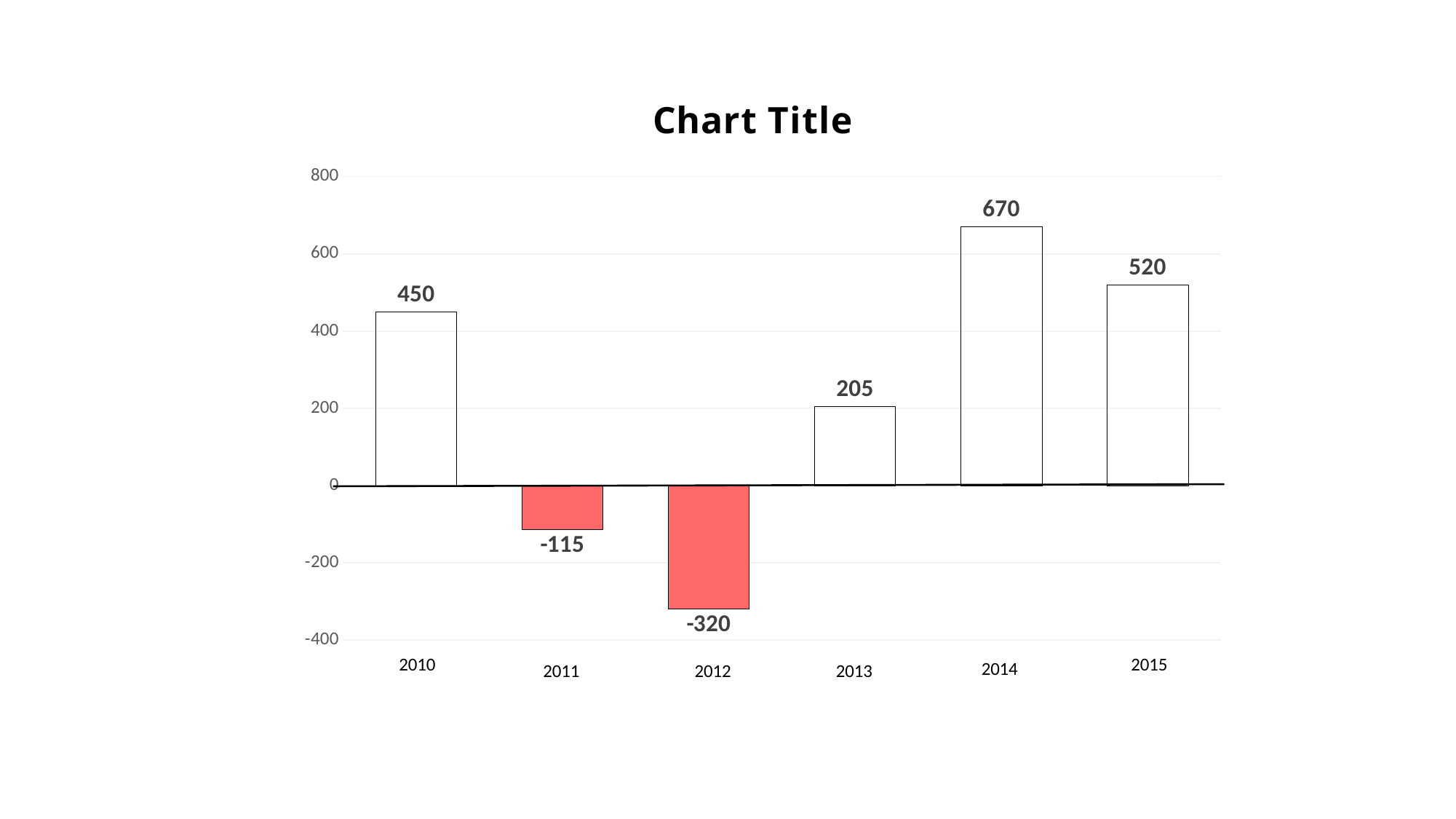
How many years are shown on the x axis? 6 What is the value for 2014? 670 What is the difference between the values for 2010 and 2013? 245 What is the difference between the values for 2014 and 2015? 150 What kind of chart is shown on the slide? Bar chart What is the value for 2010? 450 Which year has the lowest value? 2012 Which is larger, the value for 2010 or the value for 2015? 2015 Which year has the highest value? 2014 What is the value for 2011? -115 What is the title of the chart? Chart Title What is the value for 2012? -320